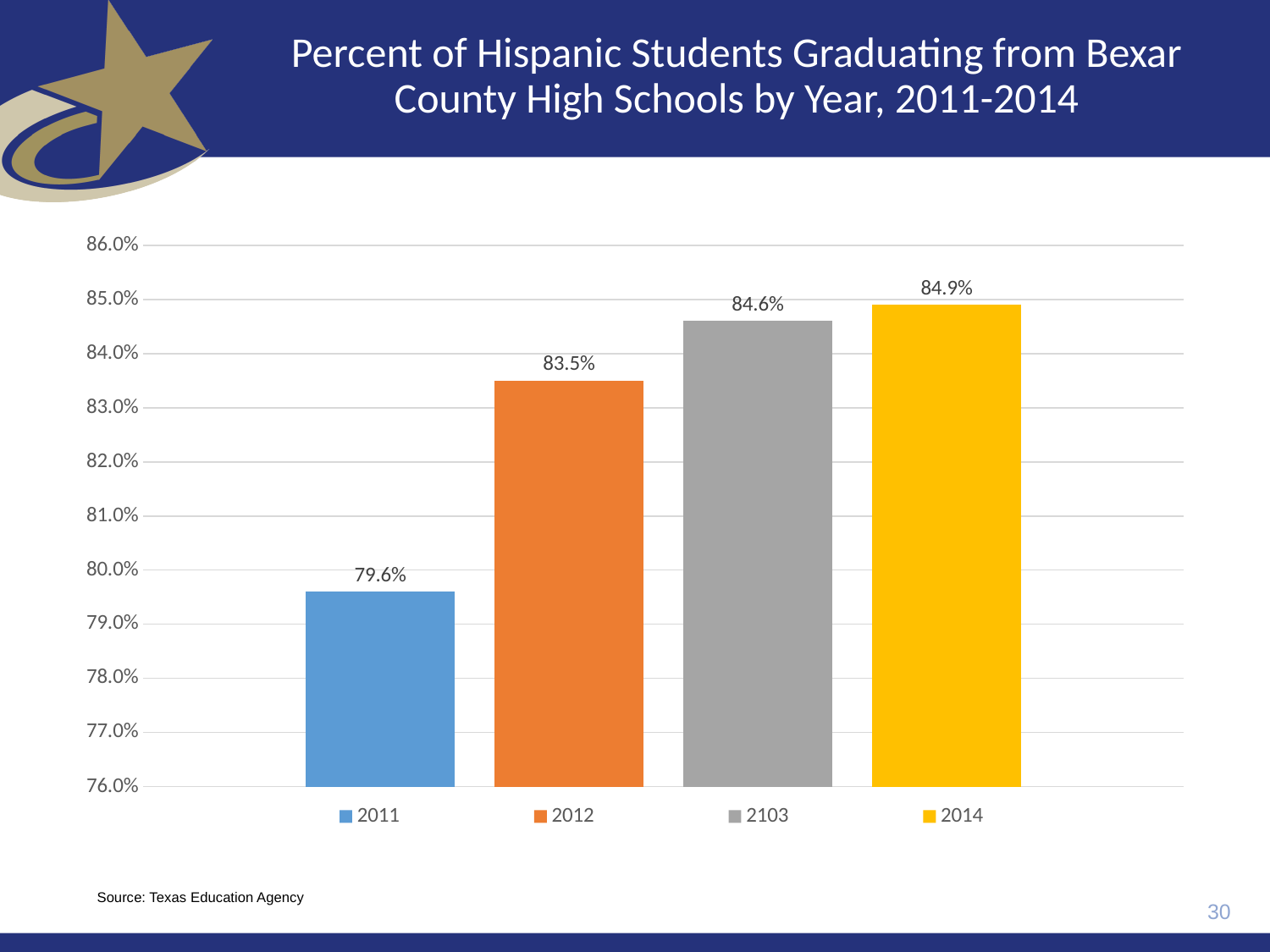
How many bars are shown in the chart? 4 Which is larger, the value for 2011 or the value for 2012? 2012 Which year has the highest graduation percentage? 2014 What is the difference between the values for 2014 and 2012? 1.4% Is the value for 2011 greater or less than 80.0%? less What is the value for 2014? 84.9% What is the difference between the values for 2012 and 2011? 3.9% What is the value for 2011? 79.6% What kind of chart is shown on the slide? bar chart Which year has the lowest graduation percentage? 2011 Do the values rise or fall from left to right across the years? rise What is the value for 2012? 83.5%